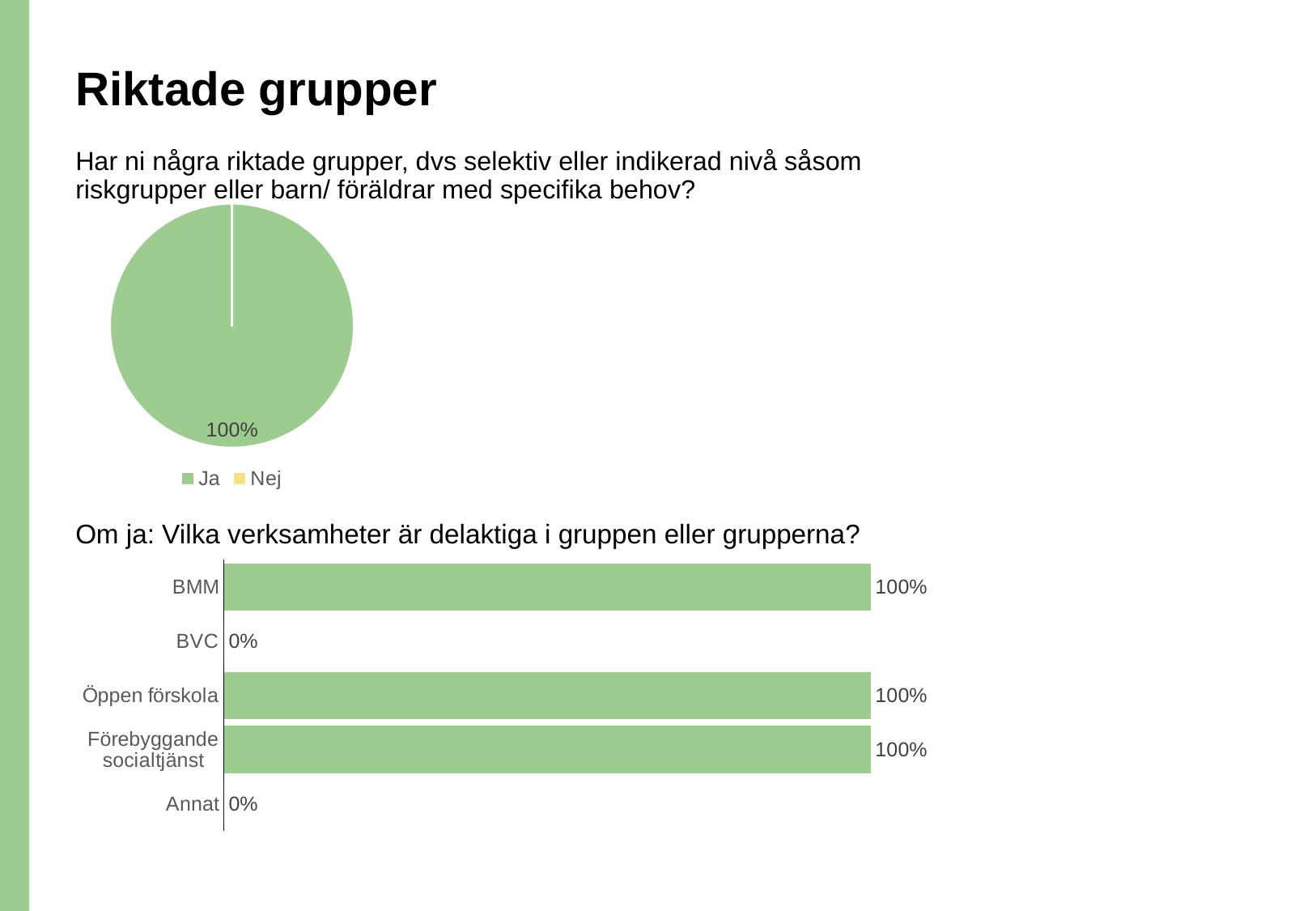
In the bottom bar chart, which is larger, the value for Öppen förskola or the value for BVC? Öppen förskola How many entries does the legend of the pie chart list? 2 In the bottom bar chart, what is the difference between the value for BMM and the value for Annat? 100% In the bottom bar chart, what is the value for Annat? 0% In the pie chart at the top of the slide, what share does the 'Ja' slice have? 100% In the bottom bar chart, what is the value for BMM? 100% In the bottom bar chart, what is the value for BVC? 0% What kind of chart is the top chart on the slide? pie chart In the pie chart, which legend entry is shown in yellow? Nej What kind of chart is the bottom chart on the slide? bar chart How many categories does the bottom bar chart show? 5 In the bottom bar chart, what is the value for Förebyggande socialtjänst? 100%